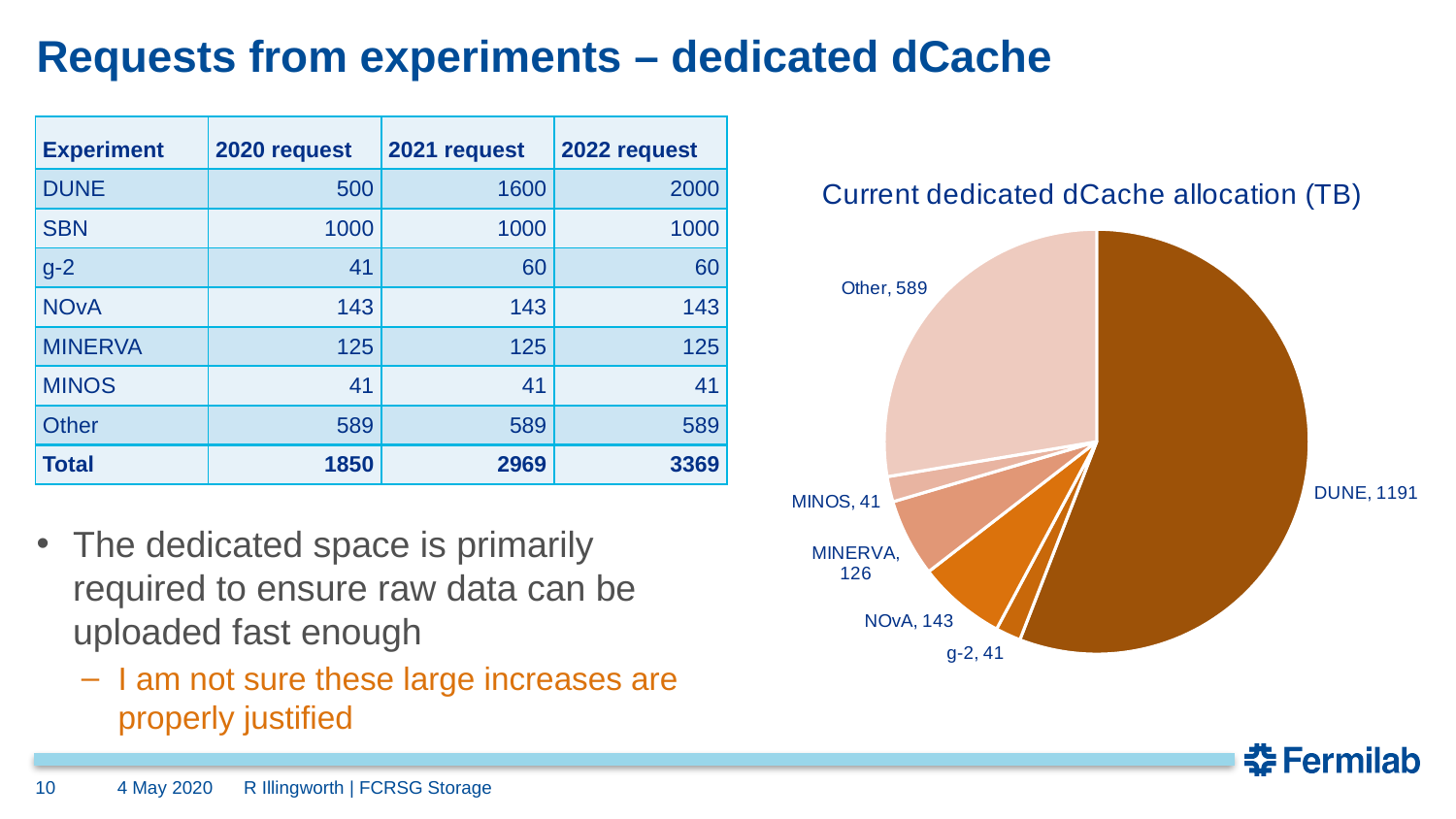
In the pie chart, which is larger, the Other slice or the NOvA slice? Other In the pie chart, what is the value shown for NOvA? 143 In the pie chart, what is the value shown for MINERVA? 126 How many slices does the pie chart have? 6 In the pie chart, what is the value shown for Other? 589 Which experiment has the largest slice in the pie chart? DUNE In the pie chart, what is the difference between the NOvA value and the MINERVA value? 17 What is the title of the pie chart? Current dedicated dCache allocation (TB) In the pie chart, what is the difference between the DUNE value and the Other value? 602 What type of chart is shown on the slide? Pie chart In the pie chart, what is the value shown for MINOS? 41 In the pie chart, what is the dedicated dCache allocation for DUNE? 1191